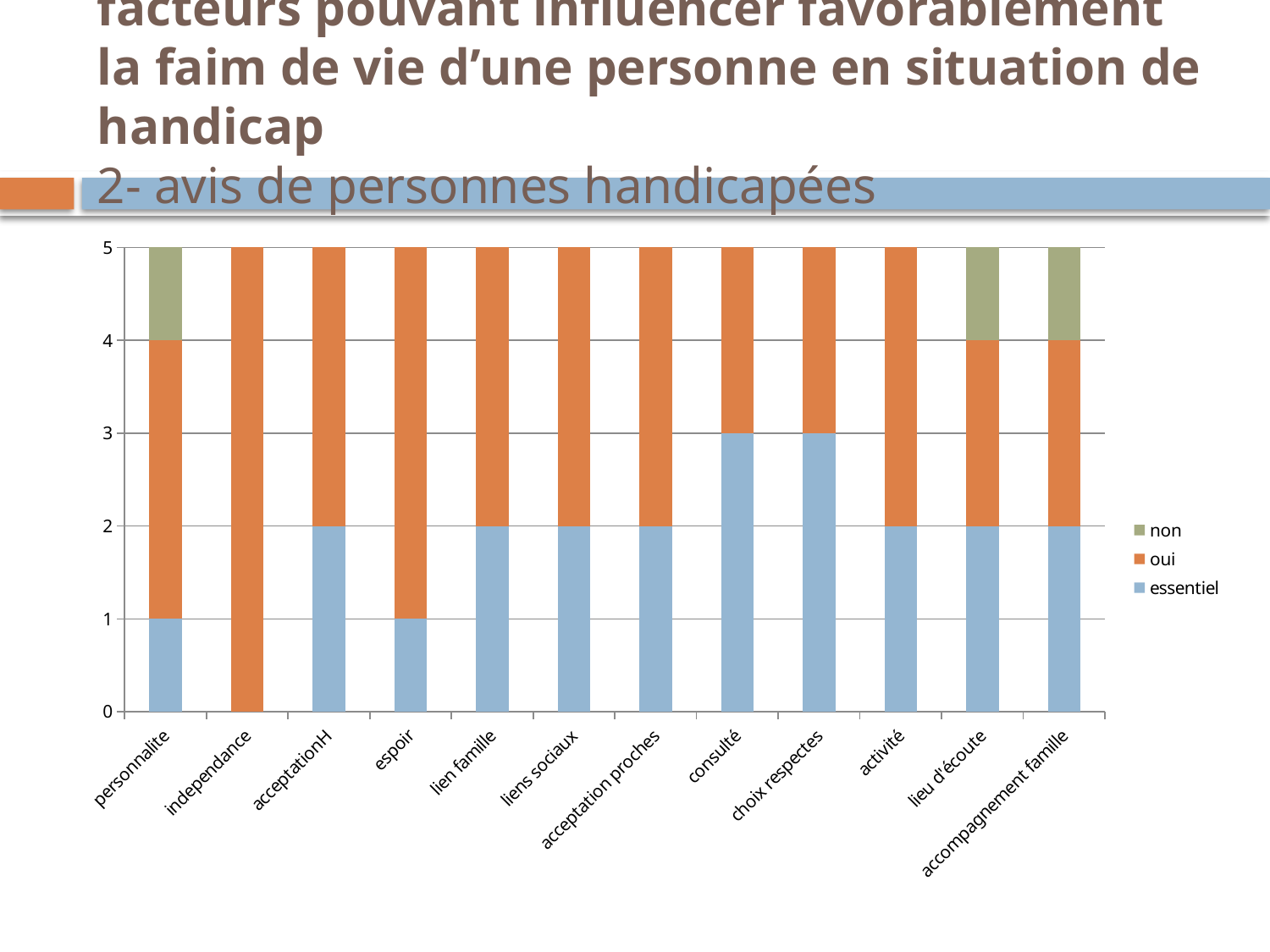
How many categories include a 'non' segment? 3 Which category has the lowest 'essentiel' value? independance What is the value of the 'essentiel' series for 'consulté'? 3 Which is larger: the 'essentiel' value for 'consulté' or for 'personnalite'? consulté What is the value of the 'essentiel' series for 'personnalite'? 1 How many categories are shown on the x axis? 12 What is the total height of the stacked bar for 'lieu d'écoute'? 5 What is the difference between the 'essentiel' value for 'choix respectes' and for 'espoir'? 2 Which category has the highest 'oui' value? independance How many series does the legend list? 3 Which colour represents the 'non' series in the legend? green What kind of chart is shown on the slide? stacked bar chart